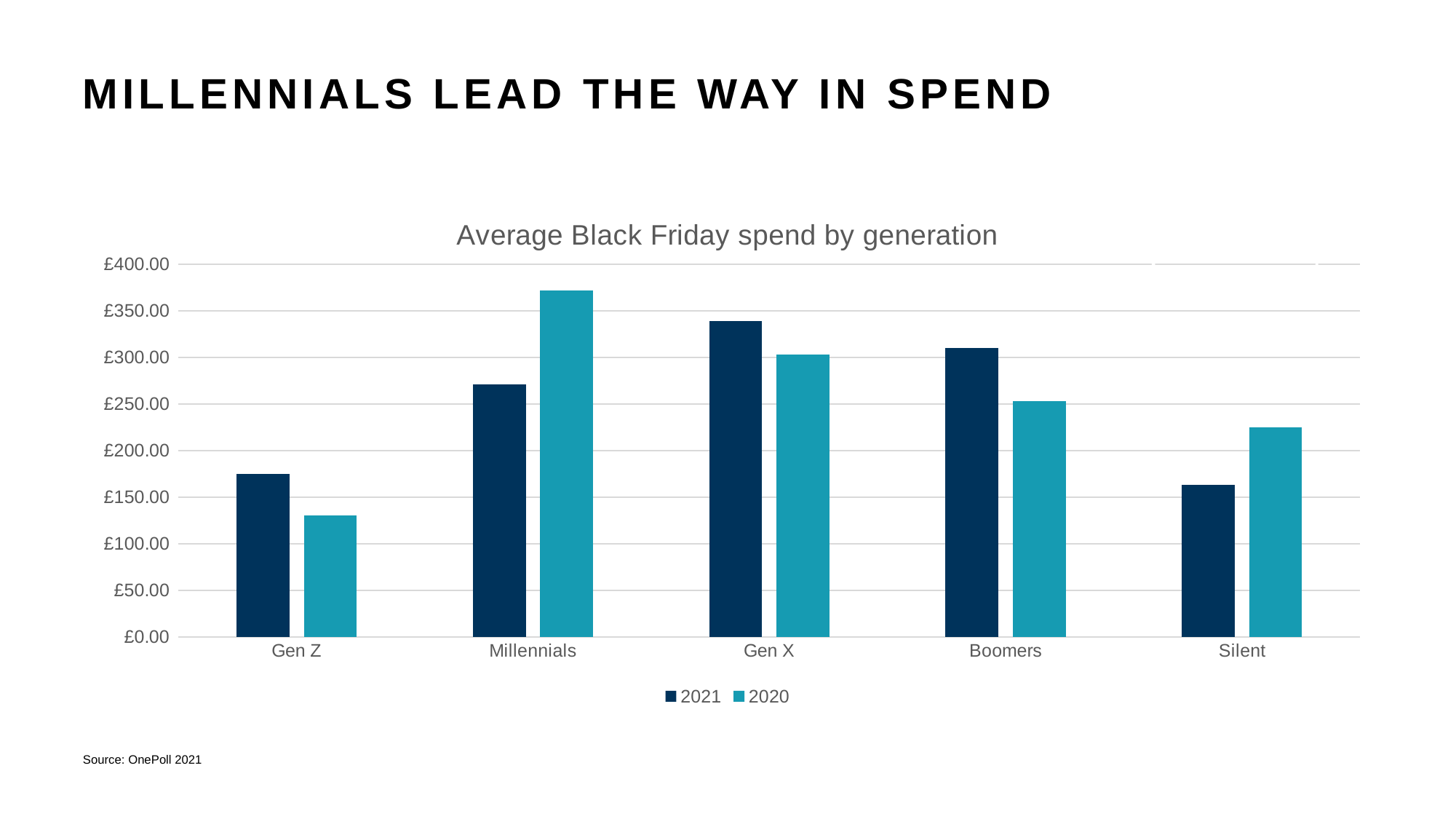
For Gen X, which is larger: the 2021 value or the 2020 value? 2021 Is the 2020 value for Millennials greater or less than £350.00? greater Is the 2021 value for Boomers greater or less than £250.00? greater For Silent, which is larger: the 2021 value or the 2020 value? 2020 What is the title of the chart? Average Black Friday spend by generation Is the 2020 value for Gen Z greater or less than £150.00? less Which generation has the highest 2021 average Black Friday spend? Gen X How many generations are shown on the x axis? 5 How many series does the legend list? 2 Which generation has the lowest 2020 average Black Friday spend? Gen Z What kind of chart is shown on the slide? bar chart Which generation has the highest 2020 average Black Friday spend? Millennials